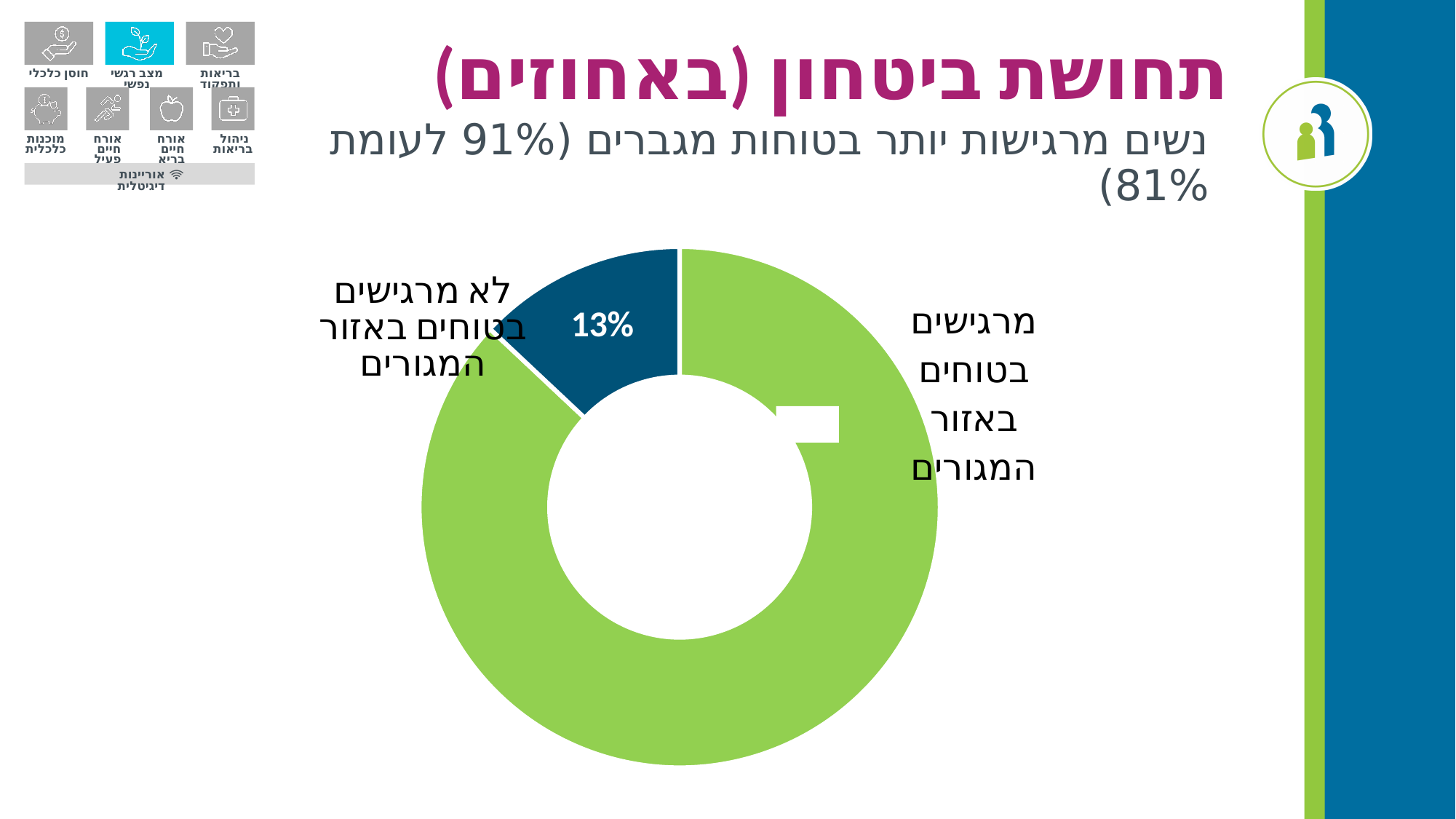
Which category has the smallest slice in the donut chart? לא מרגישים בטוחים באזור המגורים What is the value shown for the slice labelled "לא מרגישים בטוחים באזור המגורים"? 13% What colour is the slice for "לא מרגישים בטוחים באזור המגורים"? Dark blue Which category has the largest slice in the donut chart? מרגישים בטוחים באזור המגורים What is the title of the slide containing the chart? תחושת ביטחון (באחוזים) Which slice is larger: "מרגישים בטוחים באזור המגורים" or "לא מרגישים בטוחים באזור המגורים"? מרגישים בטוחים באזור המגורים What kind of chart is shown on the slide? Donut (pie) chart How many categories (slices) does the chart show? 2 What share of the chart does the "לא מרגישים בטוחים באזור המגורים" slice represent? 13%